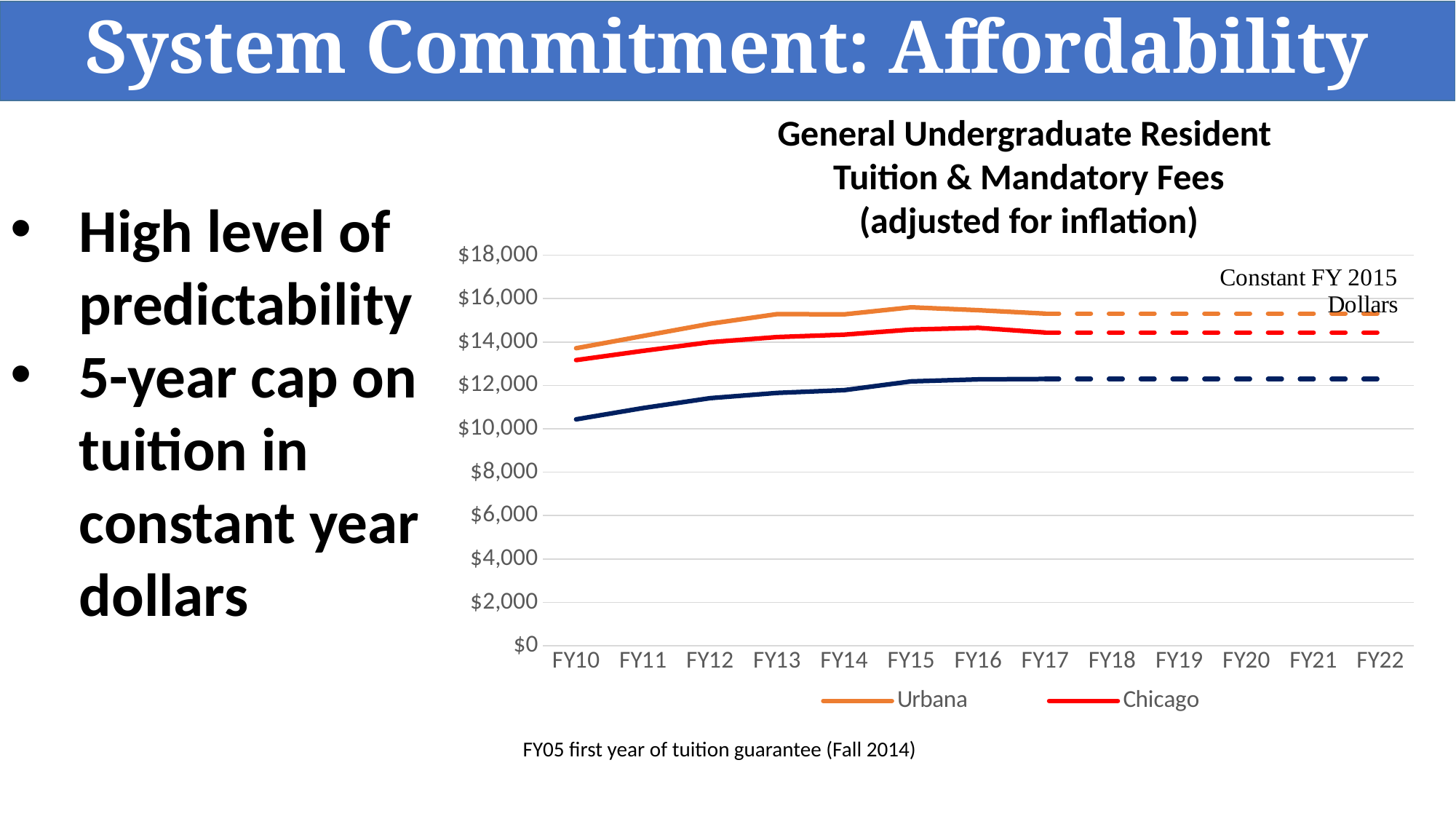
How many fiscal years are shown on the x axis of the chart? 13 What kind of chart is shown on the slide? line chart Is the value for Urbana in FY10 greater or less than $12,000? greater Is the value for Chicago in FY10 greater or less than $14,000? less How many series does the chart's legend list? 2 What is the title of the chart? General Undergraduate Resident Tuition & Mandatory Fees (adjusted for inflation) In which fiscal year is the Chicago value lowest? FY10 Which series does the legend show in orange? Urbana In FY10, which is higher, Urbana or Chicago? Urbana Is the value for Urbana in FY15 greater or less than $14,000? greater Does the Urbana line generally rise or fall from FY10 to FY15? rise